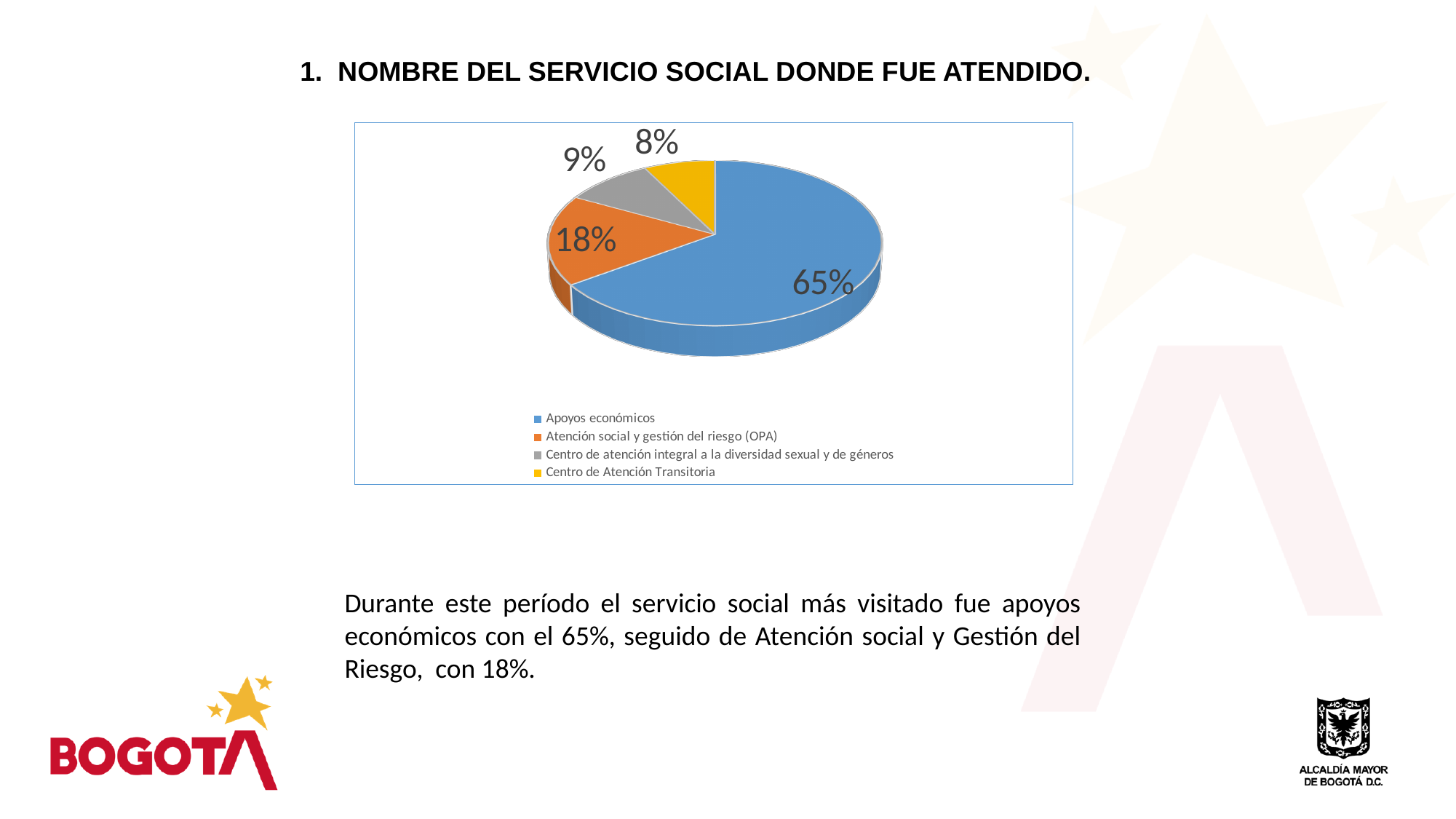
What is the value shown for Centro de atención integral a la diversidad sexual y de géneros? 9% What is the combined share of Centro de atención integral a la diversidad sexual y de géneros and Centro de Atención Transitoria? 17% Which is larger: Atención social y gestión del riesgo (OPA) or Centro de atención integral a la diversidad sexual y de géneros? Atención social y gestión del riesgo (OPA) What kind of chart is shown on the slide? Pie chart How many categories does the pie chart show? 4 What is the value shown for Centro de Atención Transitoria? 8% What colour is the slice for Centro de Atención Transitoria? Yellow Which category has the smallest slice of the pie? Centro de Atención Transitoria What is the value shown for Atención social y gestión del riesgo (OPA)? 18% What share of the pie does Apoyos económicos represent? 65% What is the difference in percentage points between Apoyos económicos and Atención social y gestión del riesgo (OPA)? 47 Which category has the largest slice of the pie? Apoyos económicos